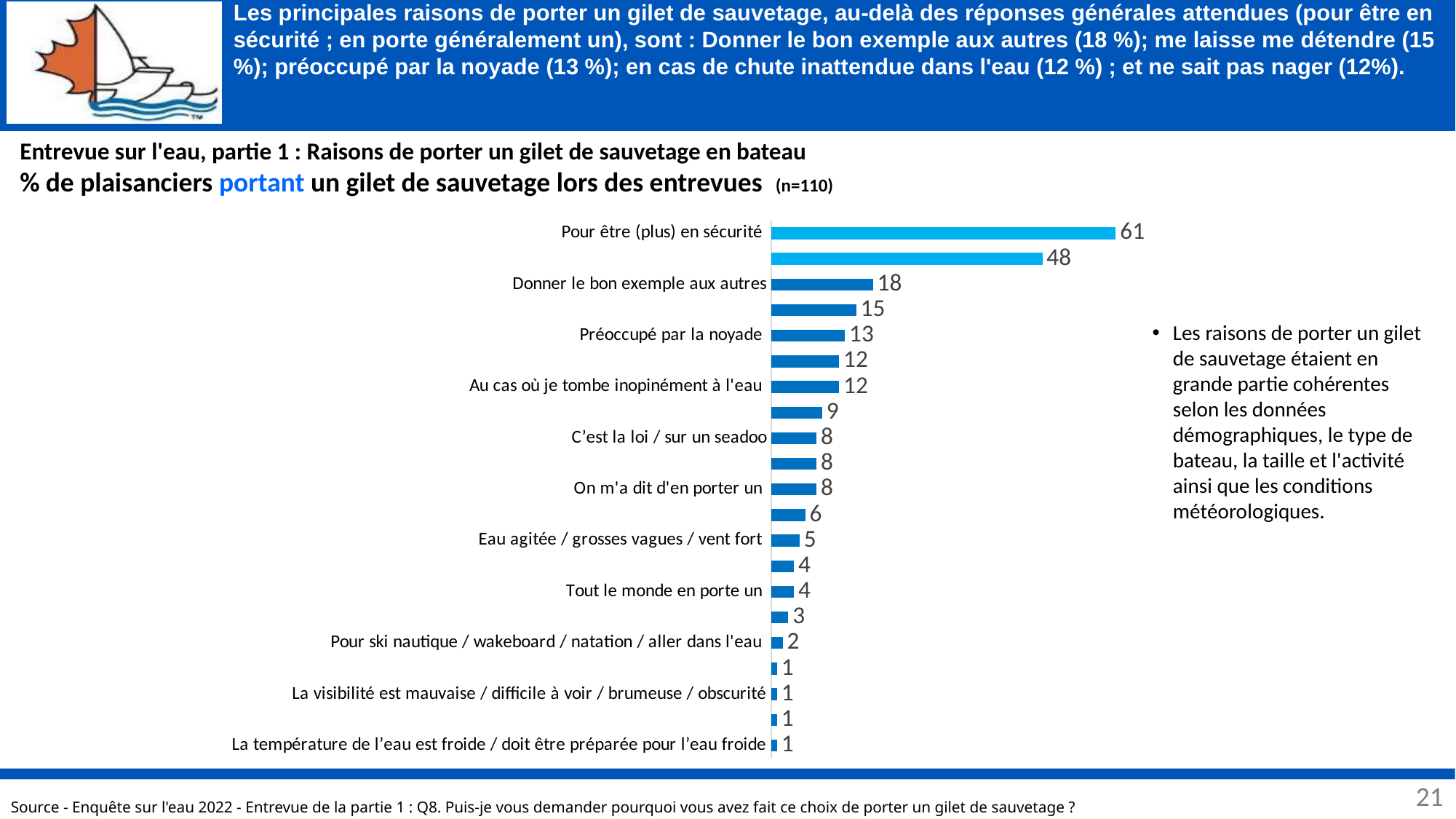
What is the difference between the values for "Donner le bon exemple aux autres" and "Préoccupé par la noyade"? 5 What is the value for "Donner le bon exemple aux autres"? 18 How many bars are plotted in the chart? 21 What is the difference between the values for "Pour être (plus) en sécurité" and "Donner le bon exemple aux autres"? 43 Which is larger: the value for "Préoccupé par la noyade" or for "Tout le monde en porte un"? Préoccupé par la noyade What is the value for "Pour être (plus) en sécurité"? 61 What kind of chart is shown on the slide? Bar chart What is the value of the second bar from the top, directly below "Pour être (plus) en sécurité"? 48 What is the value for "Eau agitée / grosses vagues / vent fort"? 5 What is the value for "Au cas où je tombe inopinément à l'eau"? 12 What is the value for "Préoccupé par la noyade"? 13 Which category has the highest value? Pour être (plus) en sécurité